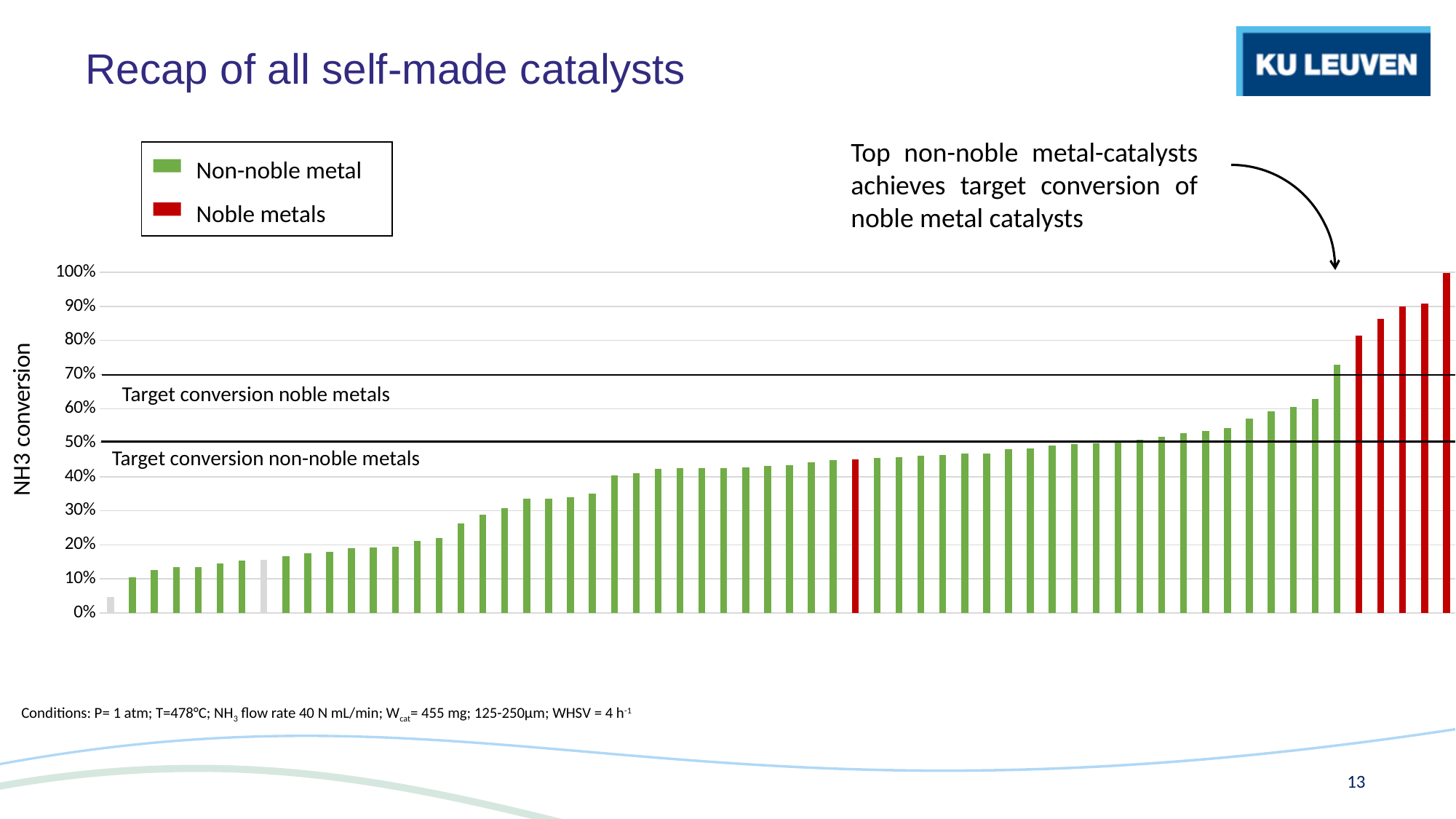
Is the value of the tallest green bar greater or less than 60%? greater Is the value of the rightmost bar greater or less than 90%? greater Which two entries appear in the legend? Non-noble metal and Noble metals What is the label of the vertical axis? NH3 conversion What kind of chart is shown on the slide? bar chart How many red (noble metal) bars are in the chart? 6 Which is larger, the rightmost red bar or the tallest green bar? the rightmost red bar Is the value of the leftmost bar greater or less than 10%? less How many series does the legend list? 2 At what conversion level is the 'Target conversion non-noble metals' line drawn? 50% At what conversion level is the 'Target conversion noble metals' line drawn? 70% Do the bar values rise or fall from left to right along the x axis? rise